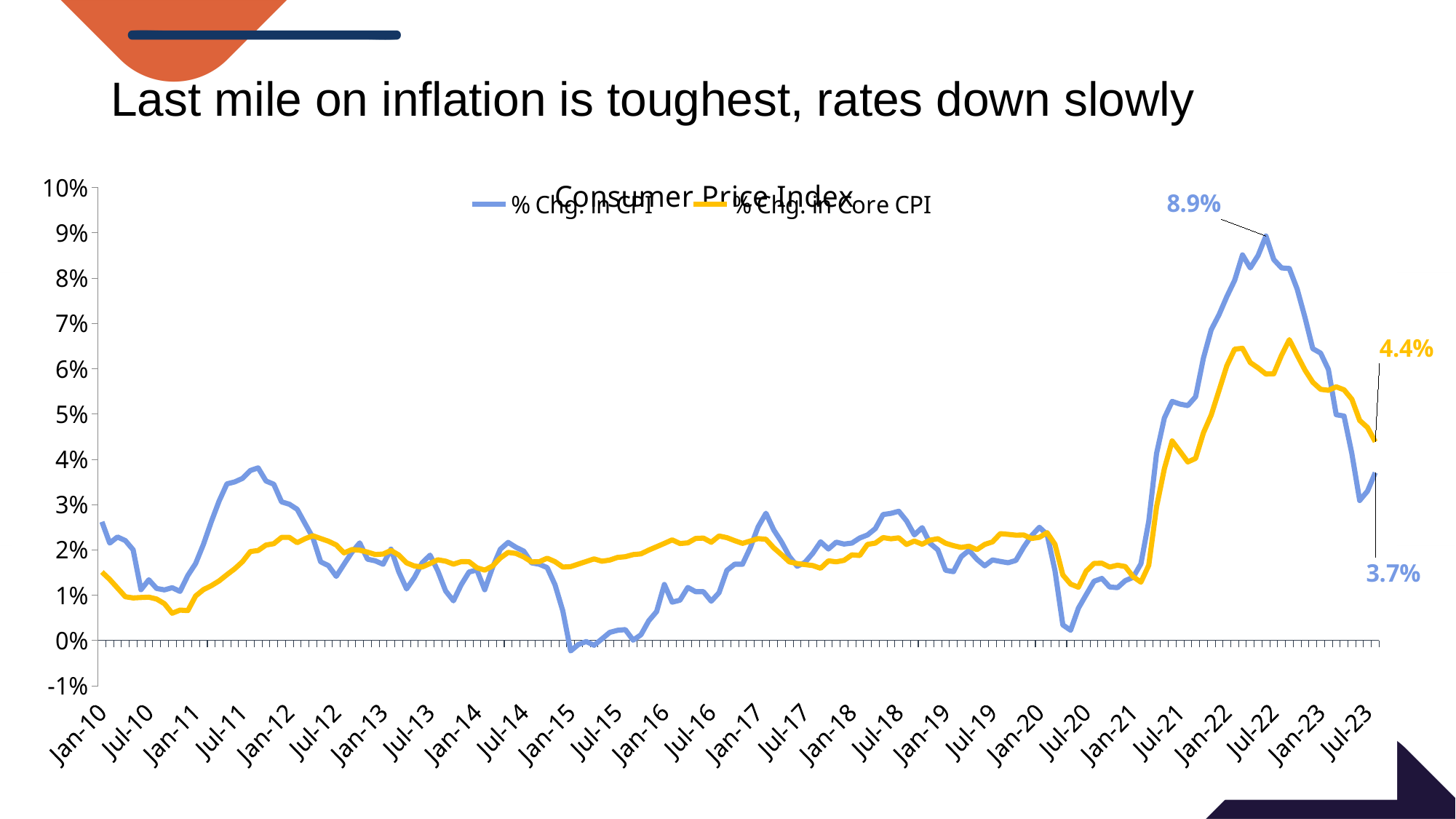
Which series reaches the higher peak on the chart? % Chg. in CPI What is the final labelled value of the % Chg. in CPI line? 3.7% How much lower is the final labelled CPI value (3.7%) than the labelled CPI peak (8.9%)? 5.2 percentage points How many series does the legend of the Consumer Price Index chart list? 2 What kind of chart is shown on the slide? line chart What is the title of the chart? Consumer Price Index Does the % Chg. in CPI line rise or fall between Jul-22 and Jan-23? fall What is the final labelled value of the % Chg. in Core CPI line? 4.4% What is the peak value labelled on the % Chg. in CPI line? 8.9% What is the difference between the final labelled Core CPI value (4.4%) and the final labelled CPI value (3.7%)? 0.7 percentage points At the end of the chart, which is higher: % Chg. in CPI or % Chg. in Core CPI? % Chg. in Core CPI Is the value of % Chg. in CPI at Jan-22 greater or less than 5%? greater